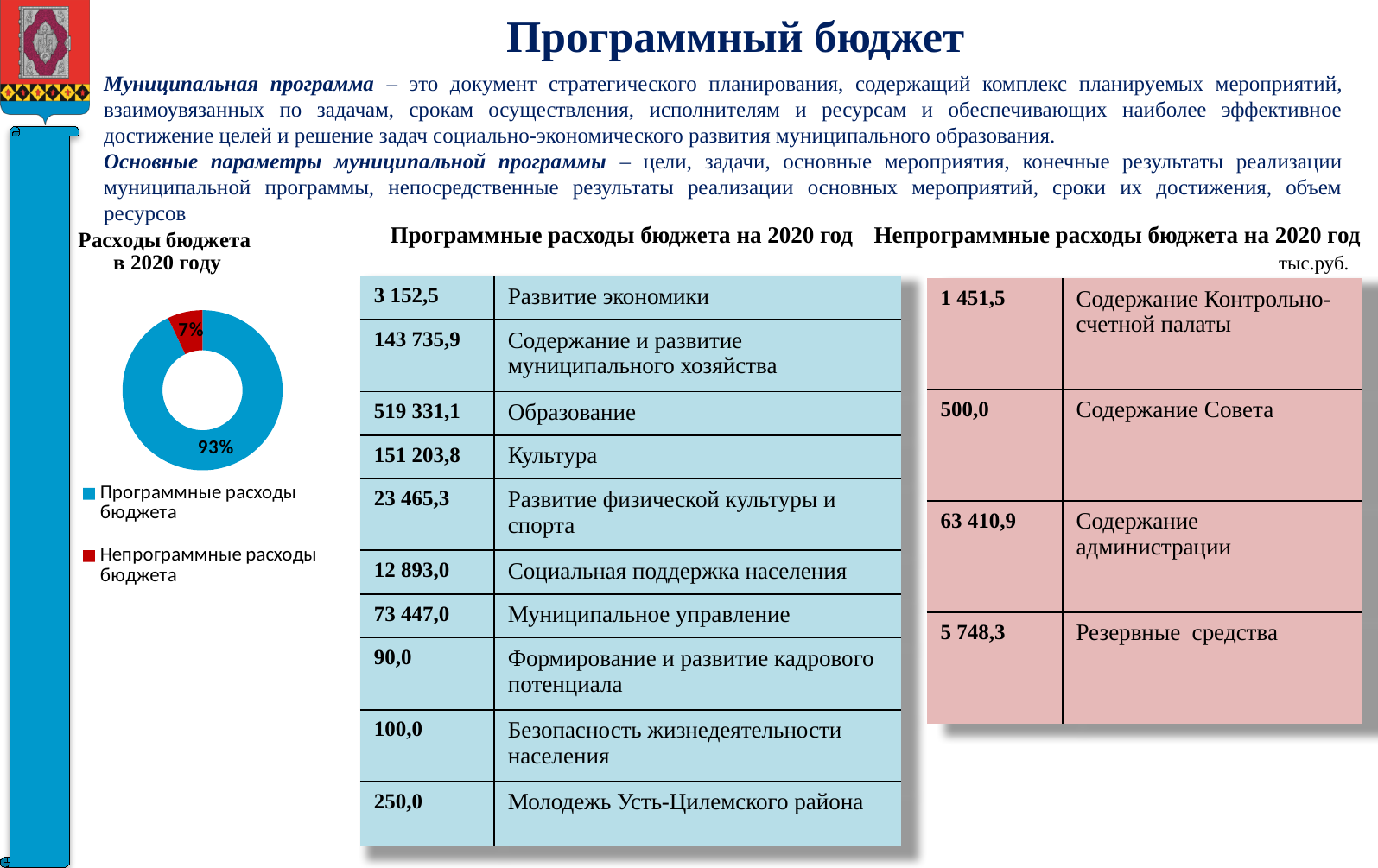
How many entries does the legend of the doughnut chart "Расходы бюджета в 2020 году" list? 2 What share of the doughnut chart "Расходы бюджета в 2020 году" is "Программные расходы бюджета"? 93% In the doughnut chart "Расходы бюджета в 2020 году", which is larger: "Программные расходы бюджета" or "Непрограммные расходы бюджета"? Программные расходы бюджета Which category has the smallest slice in the doughnut chart "Расходы бюджета в 2020 году"? Непрограммные расходы бюджета What colour represents "Программные расходы бюджета" in the doughnut chart? Blue What colour represents "Непрограммные расходы бюджета" in the doughnut chart? Red In the doughnut chart "Расходы бюджета в 2020 году", what is the difference in percentage points between the programme and non-programme expenditure shares? 86 percentage points Which category has the largest slice in the doughnut chart "Расходы бюджета в 2020 году"? Программные расходы бюджета What share of the doughnut chart "Расходы бюджета в 2020 году" is "Непрограммные расходы бюджета"? 7% How many categories are shown in the doughnut chart "Расходы бюджета в 2020 году"? 2 What type of chart is shown under the title "Расходы бюджета в 2020 году"? Doughnut (pie) chart